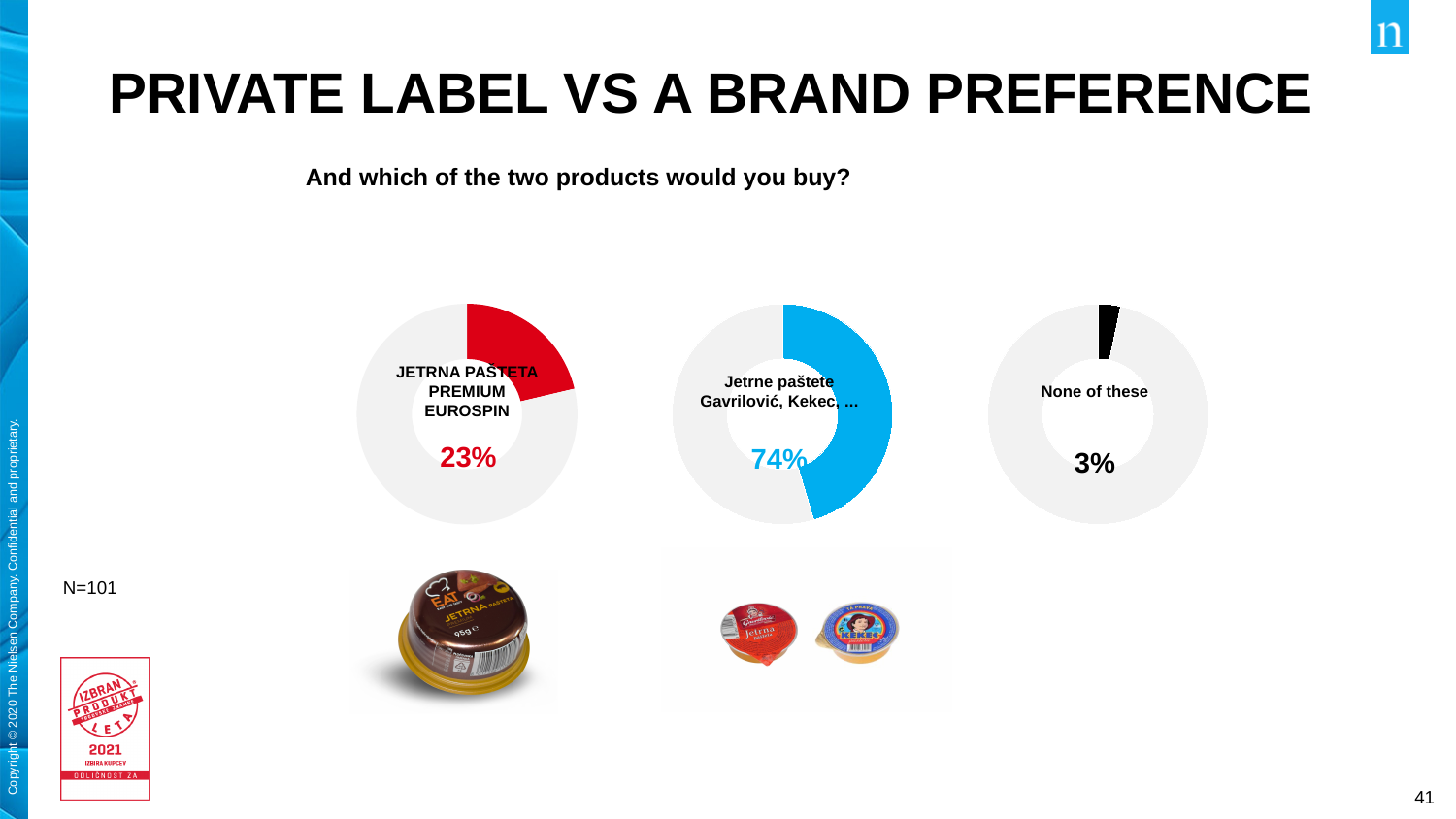
What percentage is shown in the donut chart for Jetrne paštete Gavrilović, Kekec, ...? 74% What is the total of the three percentages shown on the slide? 100% How many donut charts are shown on the slide? 3 Which of the three options has the highest percentage? Jetrne paštete Gavrilović, Kekec, ... Which of the three options has the lowest percentage? None of these What is the difference in percentage points between Jetrne paštete Gavrilović, Kekec, ... and JETRNA PAŠTETA PREMIUM EUROSPIN? 51 What percentage is shown in the donut chart for None of these? 3% What kind of chart is used to show the percentages on the slide? Donut chart What is the sample size (N) stated on the slide? N=101 What percentage is shown in the donut chart for JETRNA PAŠTETA PREMIUM EUROSPIN? 23% What colour is the filled segment of the donut chart for Jetrne paštete Gavrilović, Kekec, ...? Blue Which is larger: the percentage for JETRNA PAŠTETA PREMIUM EUROSPIN or for None of these? JETRNA PAŠTETA PREMIUM EUROSPIN